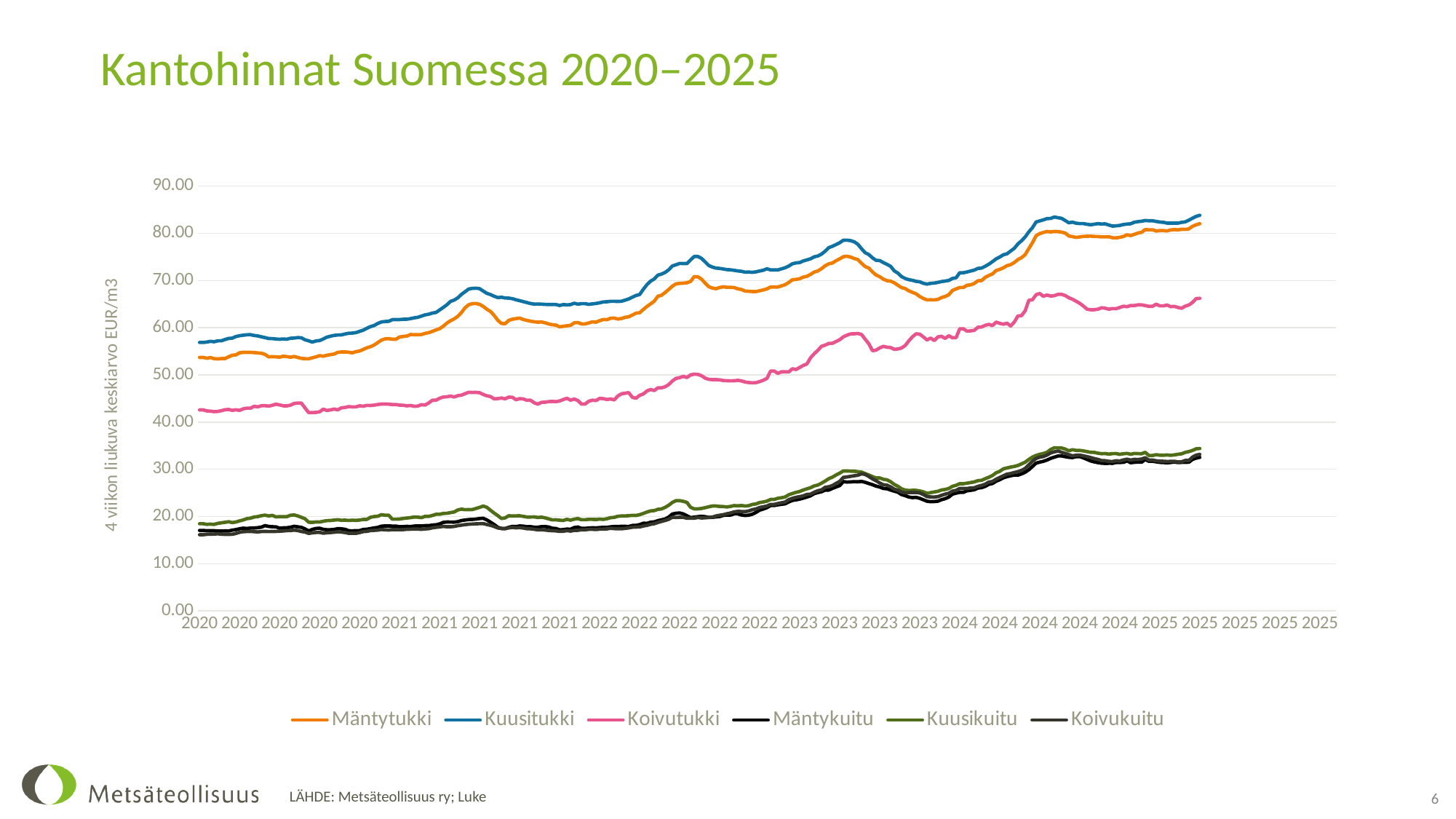
Which series has the highest values at the end of the chart in 2025? Kuusitukki Is the value for Koivutukki at the start of 2020 greater or less than 50.00? less What is the label on the vertical axis? 4 viikon liukuva keskiarvo EUR/m3 What kind of chart is shown on the slide? line chart Which is larger at the end of the chart in 2025, Koivutukki or Kuusikuitu? Koivutukki How many series does the legend list? 6 Which is larger at the start of 2020, Mäntytukki or Koivutukki? Mäntytukki Does the Koivutukki series rise or fall overall from 2020 to 2025? rise Is the value for Kuusitukki at the end of the chart in 2025 greater or less than 80.00? greater Is the value for Kuusikuitu at the end of the chart in 2025 greater or less than 40.00? less What is the title of the chart? Kantohinnat Suomessa 2020–2025 Does the Kuusitukki series rise or fall overall from 2020 to 2025? rise